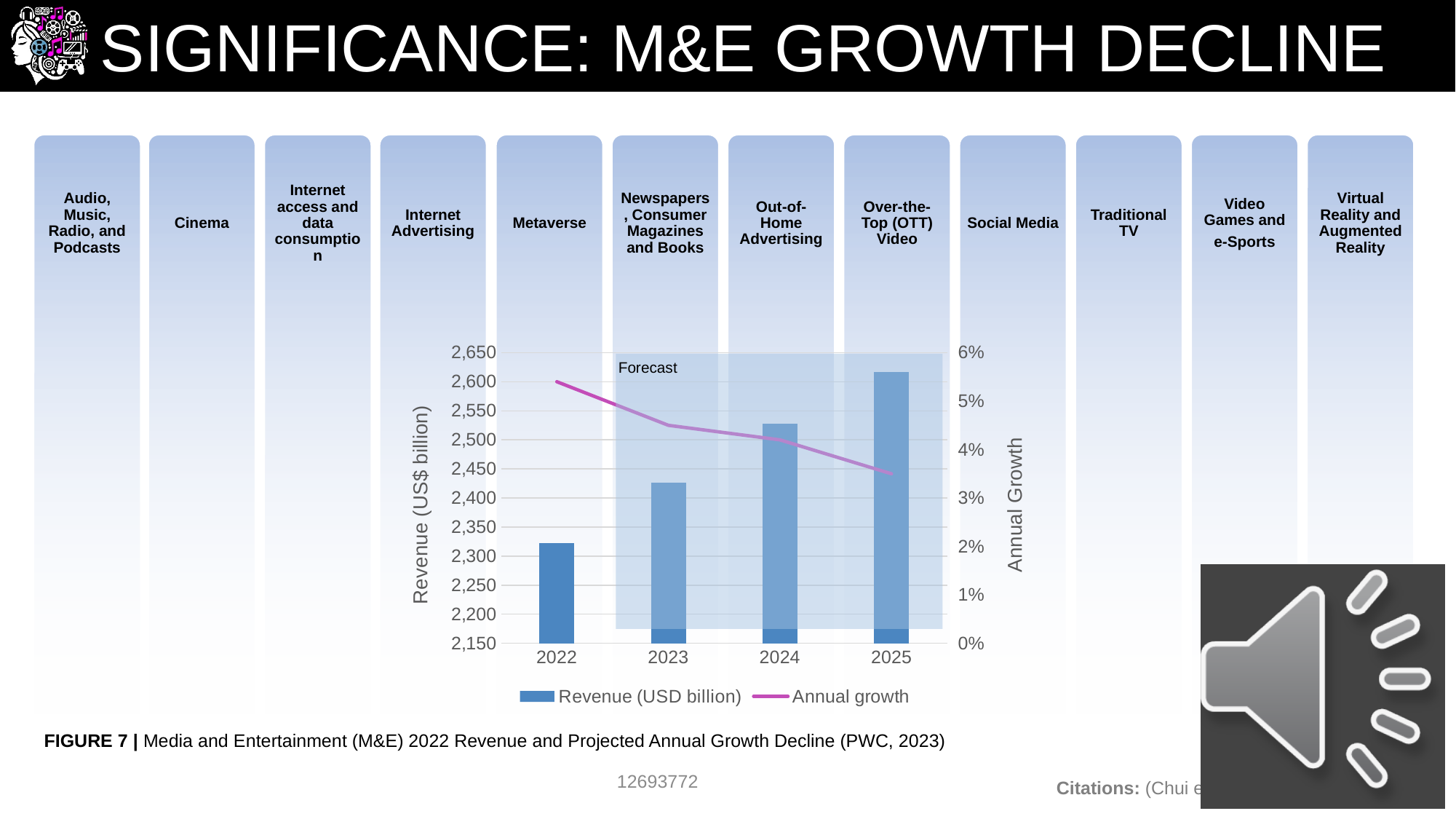
What label is shown on the shaded region covering 2023 to 2025? Forecast Does the annual growth line rise or fall from 2022 to 2025? Falls Is the annual growth for 2022 greater or less than 5%? greater How many series does the chart's legend list? 2 Which year has the higher revenue, 2023 or 2024? 2024 How many years are plotted on the x axis of the chart? 4 Is the revenue for 2025 greater or less than 2,600? greater Which year has the lowest revenue bar? 2022 Which year has the highest revenue bar? 2025 What kind of chart is shown on the slide? A combined bar and line chart Does the revenue rise or fall from 2022 to 2025? Rises Is the revenue for 2022 greater or less than 2,350? less